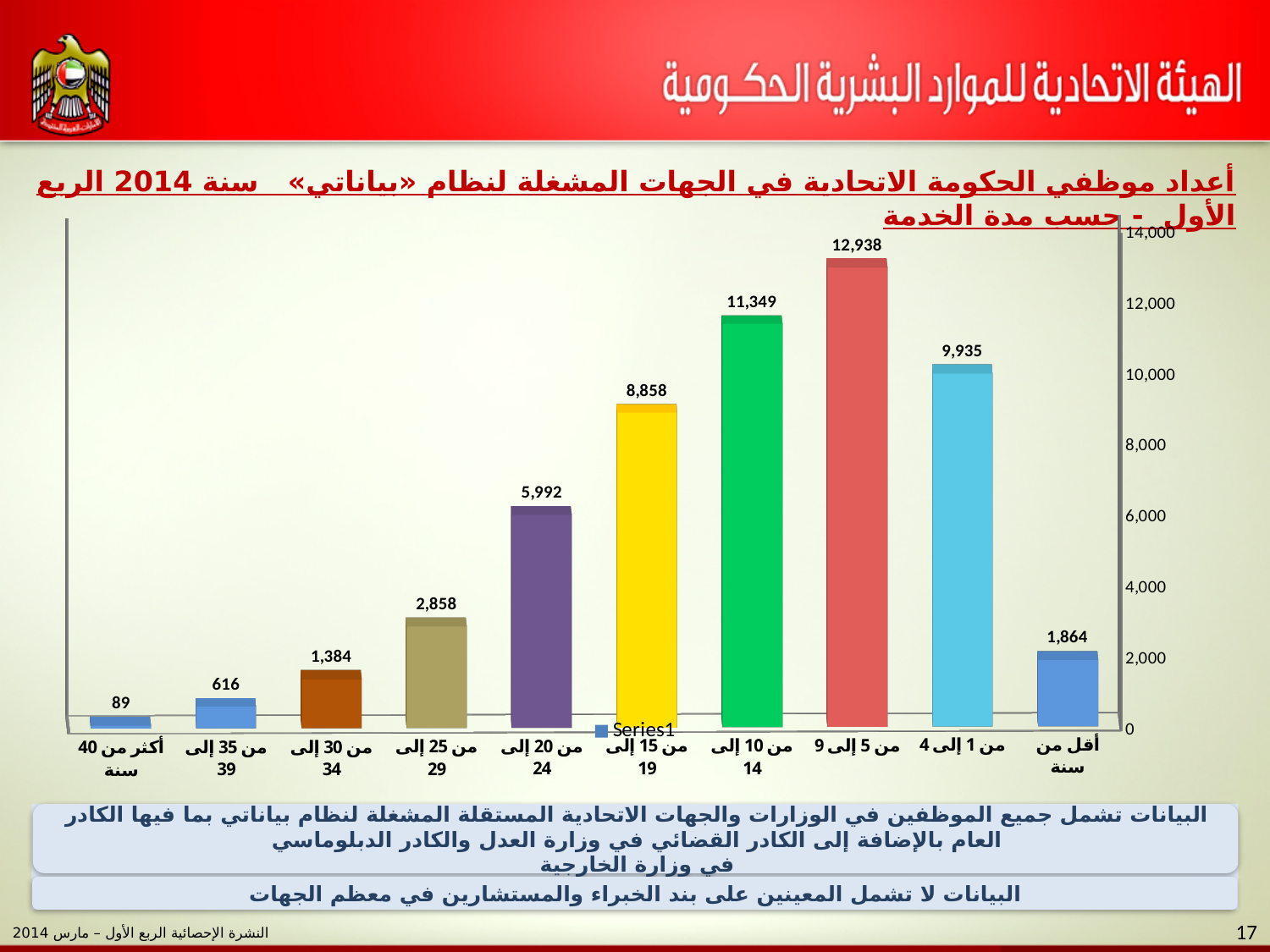
What is the legend entry shown below the chart? Series1 How many series does the legend list? 1 How many categories are shown on the x axis? 10 What is the value for the category "أكثر من 40 سنة"? 89 Is the value for "من 20 إلى 24" greater or less than 4,000? greater What kind of chart is shown on the slide? bar chart Which is larger, the value for "من 1 إلى 4" or the value for "من 10 إلى 14"? من 10 إلى 14 Which category has the lowest value? أكثر من 40 سنة Which category has the highest value? من 5 إلى 9 What is the difference between the values for "من 10 إلى 14" and "من 15 إلى 19"? 2,491 What is the value for the category "من 5 إلى 9"? 12,938 What is the value for the category "أقل من سنة"? 1,864